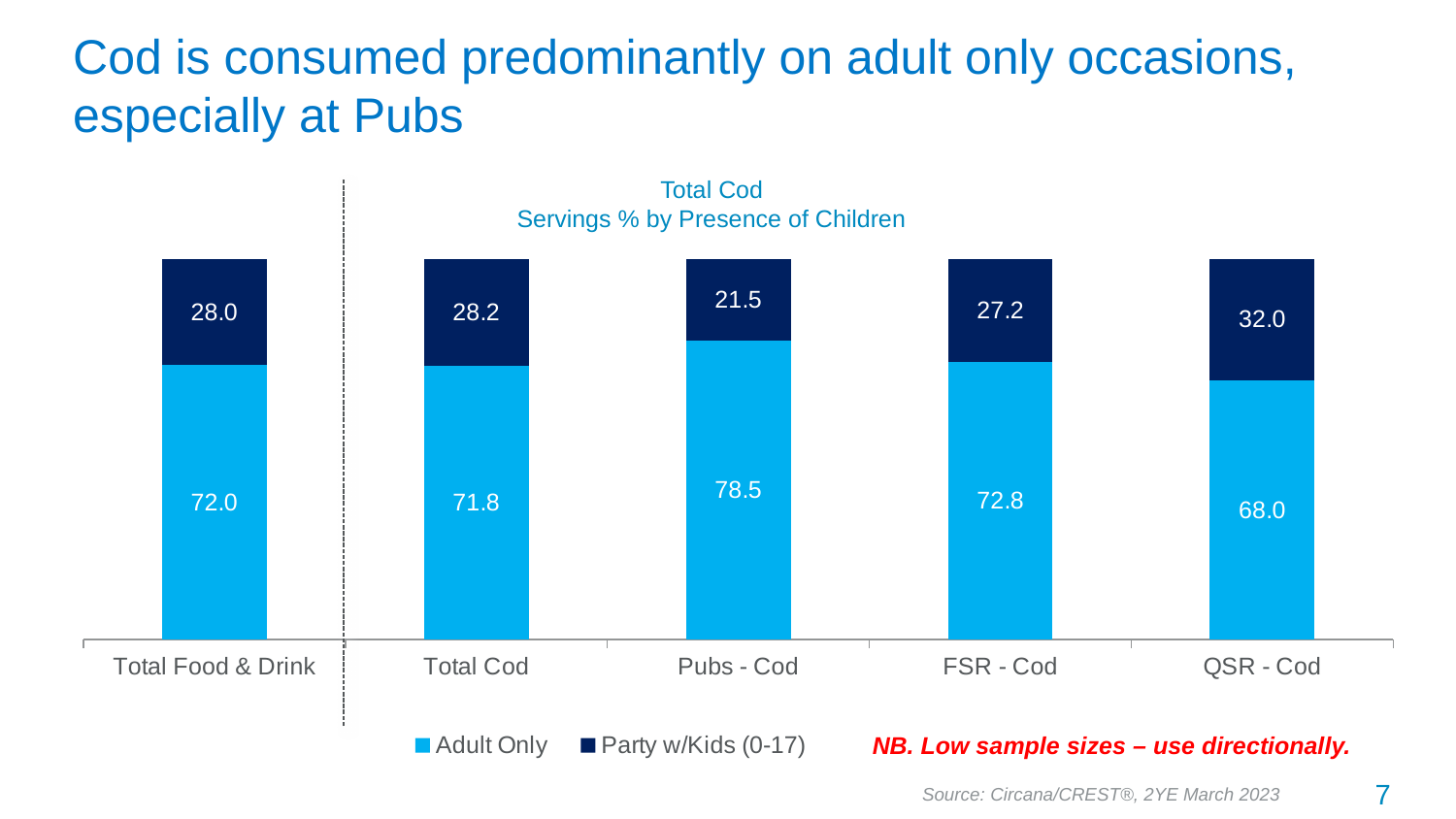
What is the difference between the Adult Only values for Pubs - Cod and QSR - Cod? 10.5 How many series does the legend list? 2 Which is larger, the Party w/Kids (0-17) value for FSR - Cod or for QSR - Cod? QSR - Cod Which category has the lowest Party w/Kids (0-17) value? Pubs - Cod What is the Adult Only value for Total Food & Drink? 72.0 How many categories are shown on the x axis? 5 What is the Adult Only value for Pubs - Cod? 78.5 What is the total of the stacked bar for Total Cod? 100.0 What is the title of the chart? Total Cod Servings % by Presence of Children Which category has the highest Adult Only value? Pubs - Cod What is the Party w/Kids (0-17) value for QSR - Cod? 32.0 What kind of chart is shown? Stacked bar chart